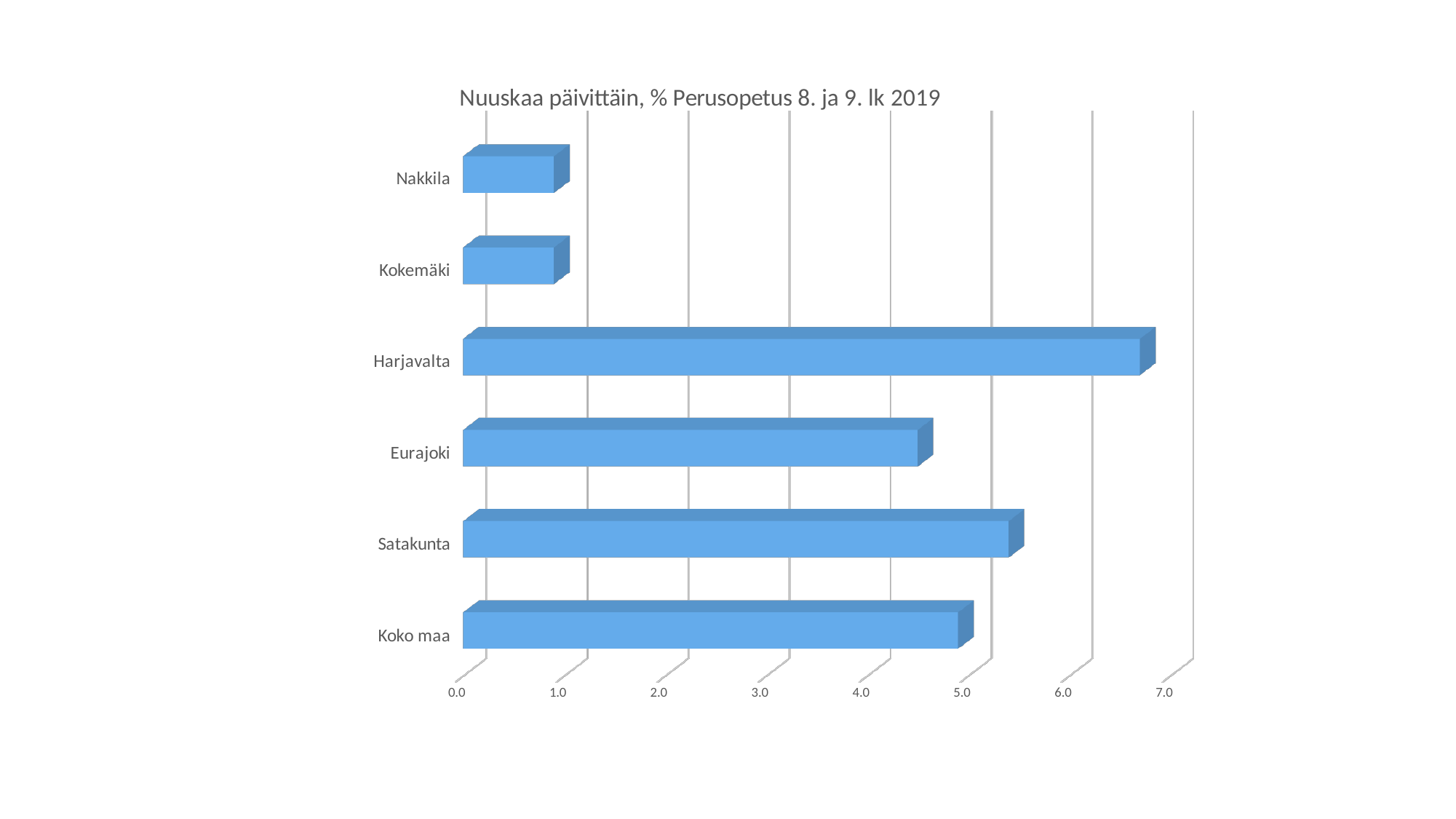
Is the value for Kokemäki greater or less than 2.0? less Which category has the highest value? Harjavalta What is the title of the chart? Nuuskaa päivittäin, % Perusopetus 8. ja 9. lk 2019 Is the value for Satakunta greater or less than 5.0? greater How many categories are plotted in the chart? 6 Which is larger, the value for Harjavalta or the value for Koko maa? Harjavalta Is the value for Harjavalta greater or less than 6.0? greater Which is larger, the value for Satakunta or the value for Eurajoki? Satakunta What kind of chart is shown on the slide? Bar chart